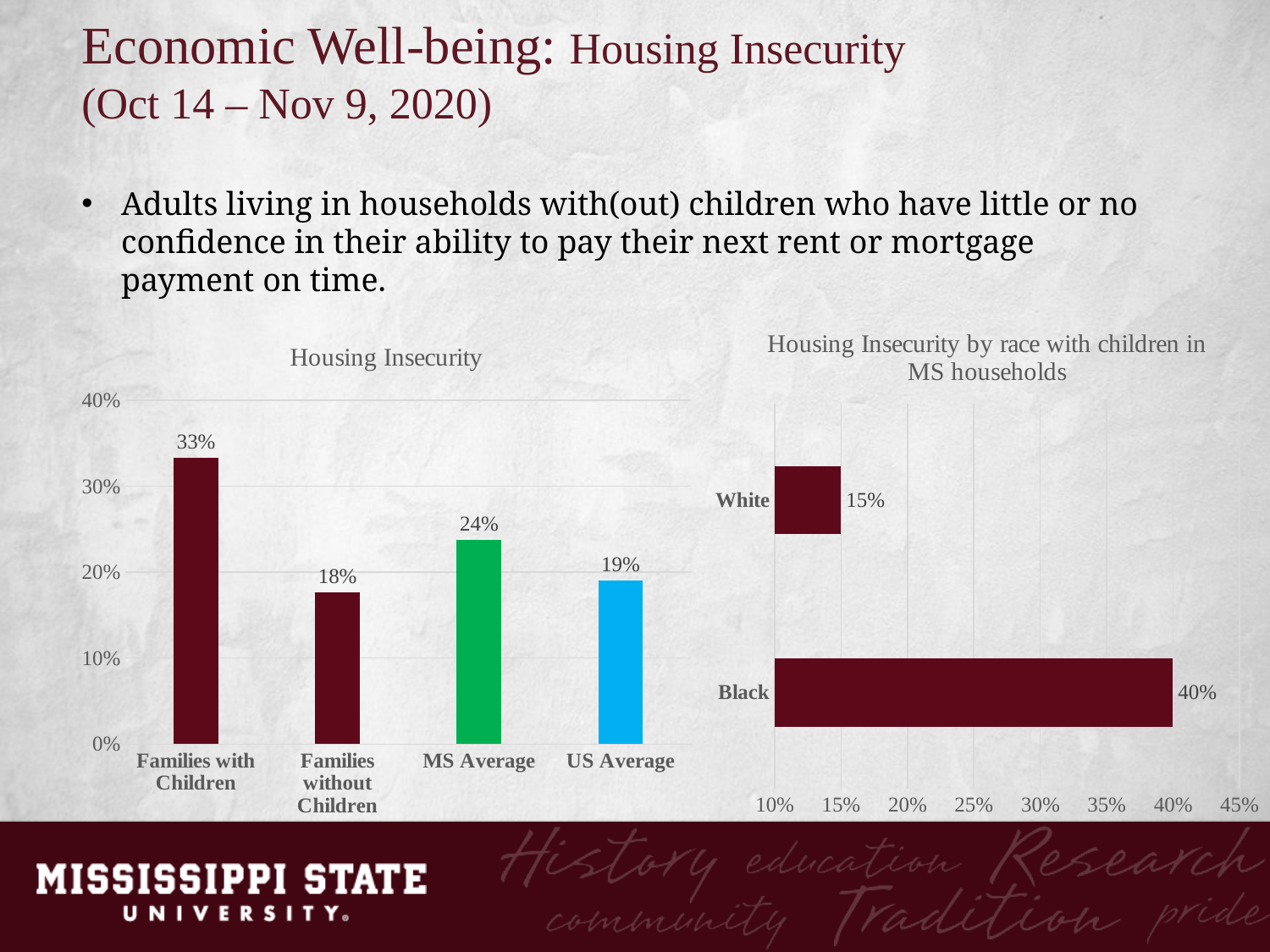
In the 'Housing Insecurity by race with children in MS households' chart, what is the value for Black? 40% In the 'Housing Insecurity' chart, what is the value for MS Average? 24% In the 'Housing Insecurity' chart, which is larger, MS Average or US Average? MS Average In the 'Housing Insecurity' chart, which category has the lowest value? Families without Children In the 'Housing Insecurity' chart, which category has the highest value? Families with Children In the 'Housing Insecurity by race with children in MS households' chart, what is the difference between Black and White? 25% In the 'Housing Insecurity by race with children in MS households' chart, what is the value for White? 15% In the 'Housing Insecurity' chart, what is the difference between Families with Children and Families without Children? 15% How many categories are shown in the 'Housing Insecurity' chart? 4 In the 'Housing Insecurity' chart, what is the value for Families without Children? 18% What kind of chart is the 'Housing Insecurity by race with children in MS households' chart? Bar chart In the 'Housing Insecurity' chart, what is the value for Families with Children? 33%